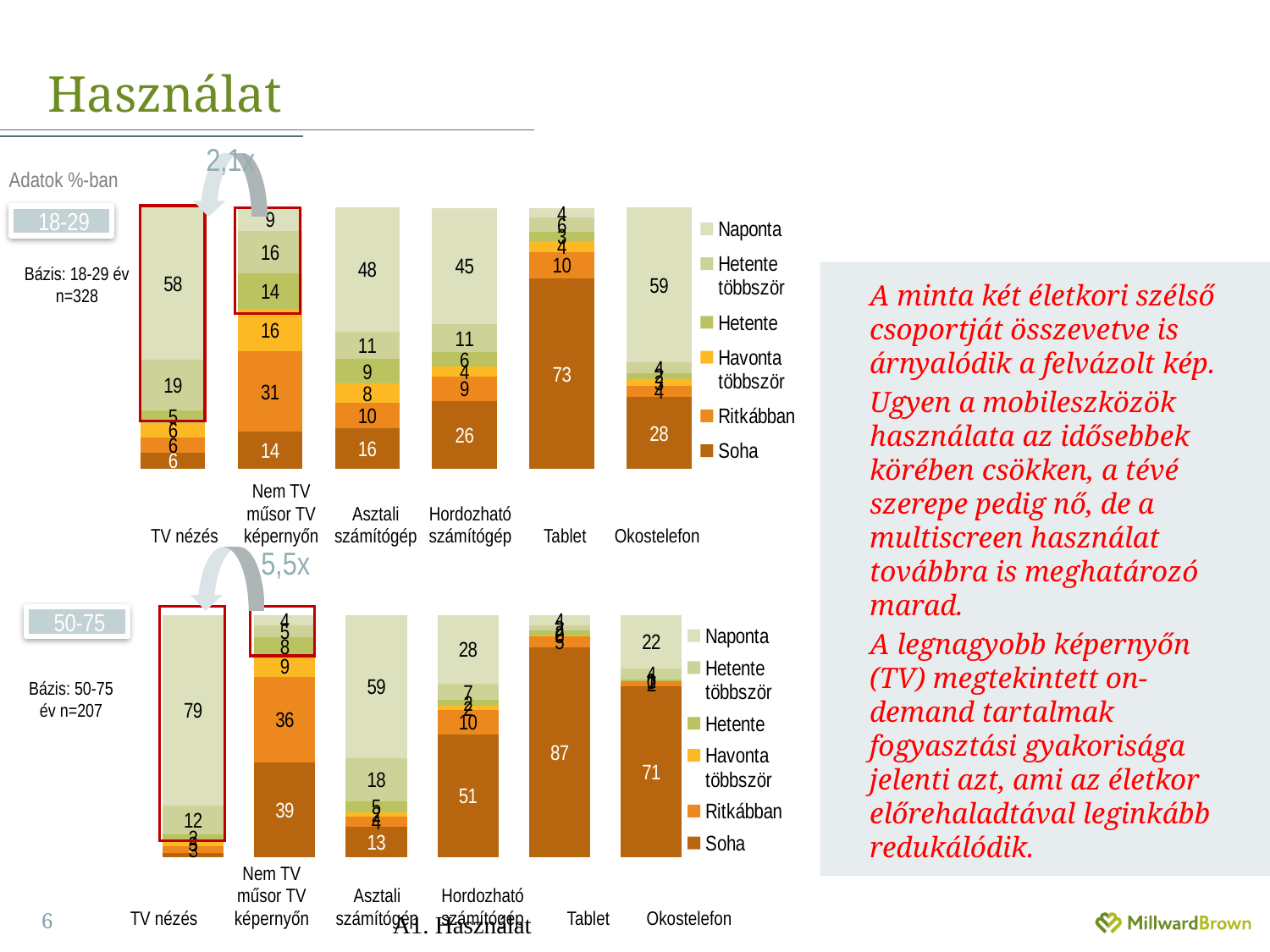
What type of chart is the top (18-29) chart? Stacked bar chart In the top (18-29) chart, what is the difference between the Naponta values for Okostelefon and Asztali számítógép? 11 In the bottom (50-75) chart, which category has the highest Soha value? Tablet In the bottom (50-75) chart, what is the Naponta value for TV nézés? 79 In the top (18-29) chart, what is the Ritkábban value for Nem TV műsor TV képernyőn? 31 In the bottom (50-75) chart, what is the Soha value for Okostelefon? 71 In the top (18-29) chart, what is the Naponta value for TV nézés? 58 How many categories are shown on the x axis of the bottom (50-75) chart? 6 In the top (18-29) chart, what is the Soha value for Tablet? 73 How many series does the legend of the top (18-29) chart list? 6 In the bottom (50-75) chart, what is the difference between the Soha values for Tablet and Okostelefon? 16 In the bottom (50-75) chart, which is larger: the Soha value for Hordozható számítógép or for Asztali számítógép? Hordozható számítógép